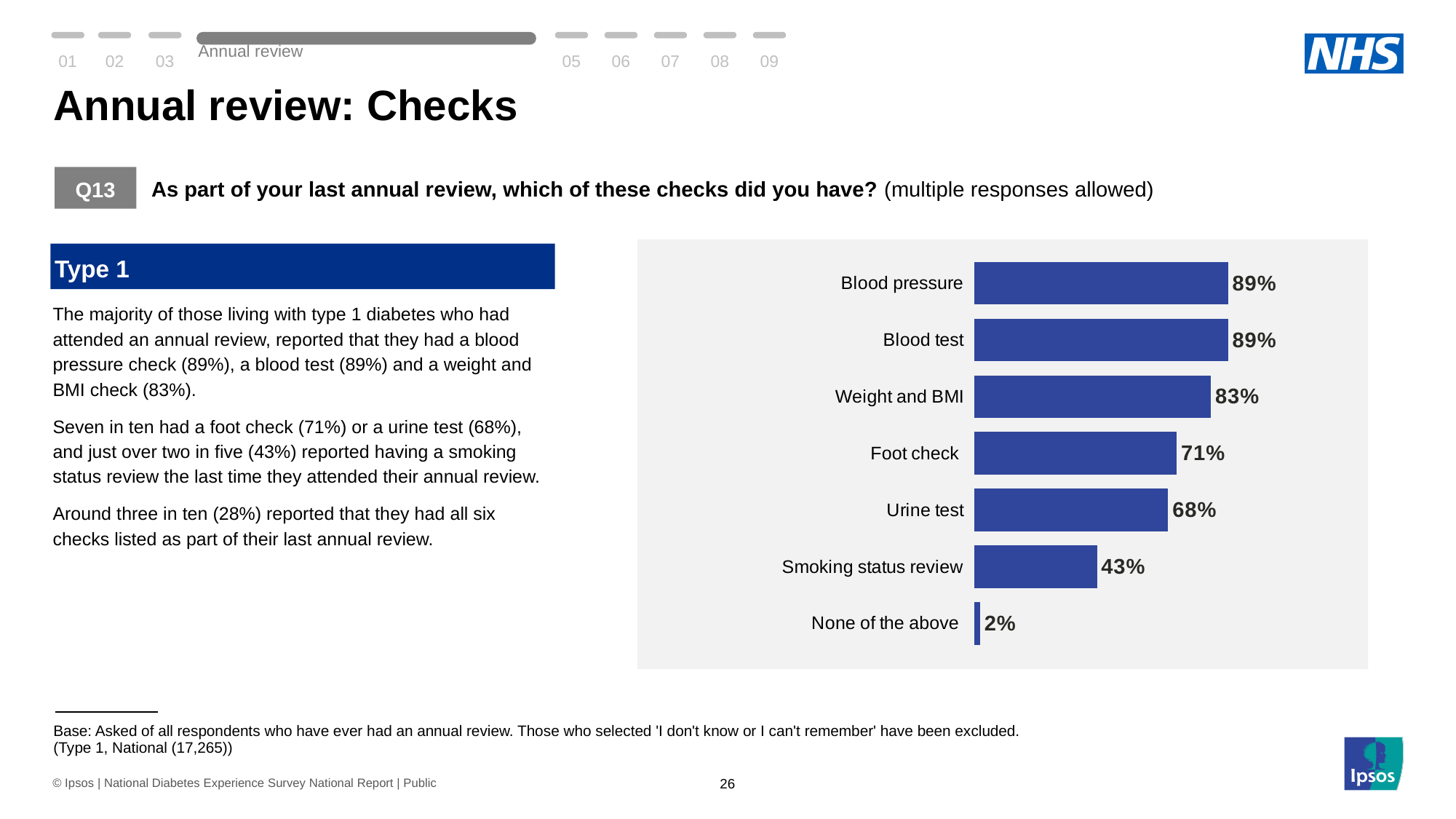
Which category has the smallest value in the chart? None of the above What percentage of respondents reported having a smoking status review? 43% What percentage of respondents selected 'None of the above'? 2% How many categories are shown in the chart? 7 Which is larger, the value for Foot check or the value for Urine test? Foot check Which check has the lowest percentage among the listed checks (excluding 'None of the above')? Smoking status review What kind of chart is shown on the slide? Bar chart What percentage of respondents reported having a foot check? 71% What is the difference in percentage points between Weight and BMI and Urine test? 15 What is the difference in percentage points between Foot check and Smoking status review? 28 What percentage of respondents reported having a blood pressure check? 89% Which two checks share the same highest value of 89%? Blood pressure and Blood test